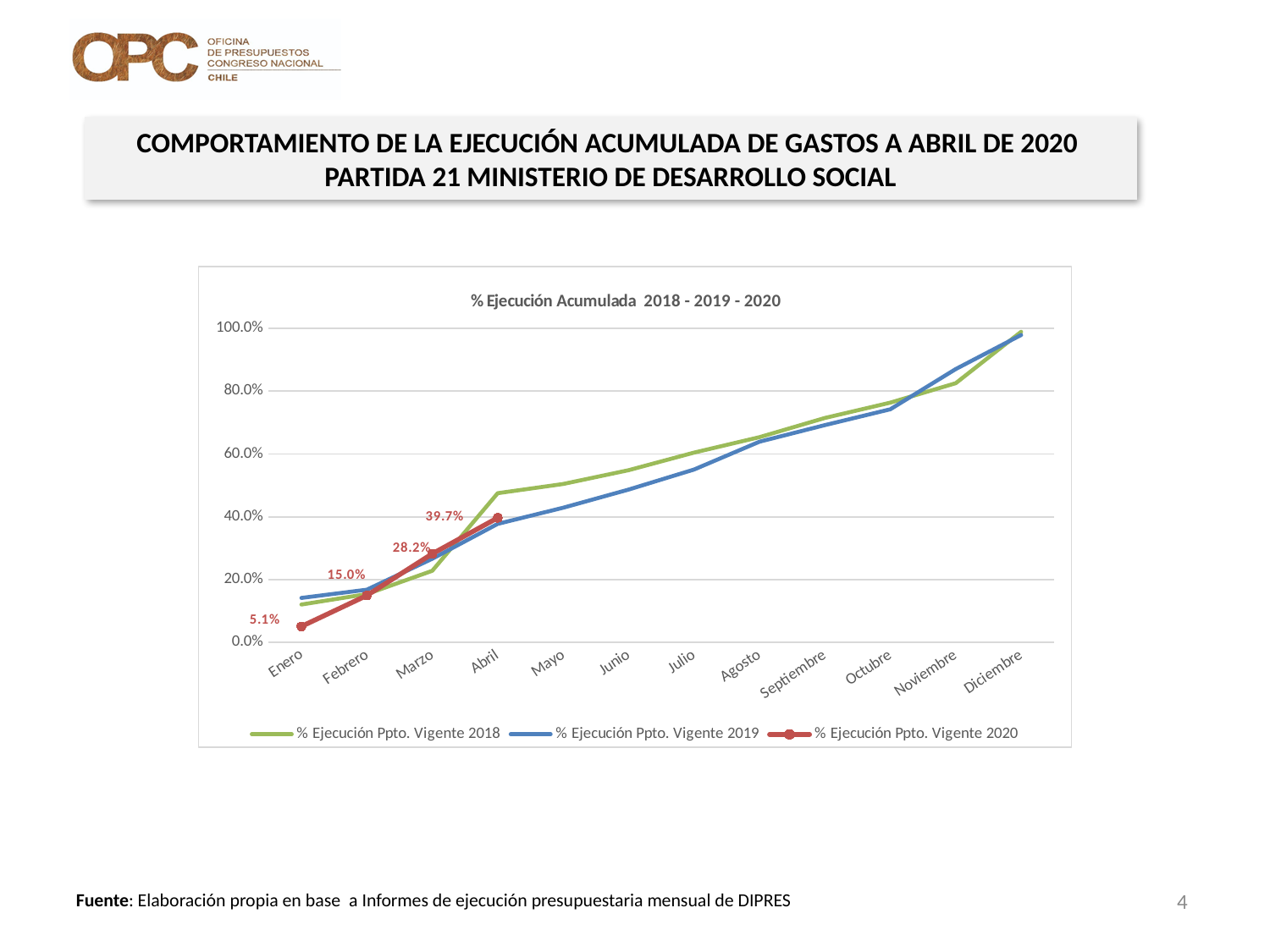
Which month has the highest value for the % Ejecución Ppto. Vigente 2020 series? Abril Is the value for % Ejecución Ppto. Vigente 2018 in Abril greater or less than 40.0%? greater How many months are shown on the x axis? 12 What is the value of % Ejecución Ppto. Vigente 2020 for Abril? 39.7% What is the value of % Ejecución Ppto. Vigente 2020 for Enero? 5.1% What kind of chart is shown on the slide? Line chart What is the difference between the 2020 values for Abril and Marzo? 11.5% Do the values of the % Ejecución Ppto. Vigente 2019 series rise or fall from Enero to Diciembre? Rise What is the value of % Ejecución Ppto. Vigente 2020 for Marzo? 28.2% How many series does the legend list? 3 What is the title of the chart? % Ejecución Acumulada 2018 - 2019 - 2020 What is the value of % Ejecución Ppto. Vigente 2020 for Febrero? 15.0%